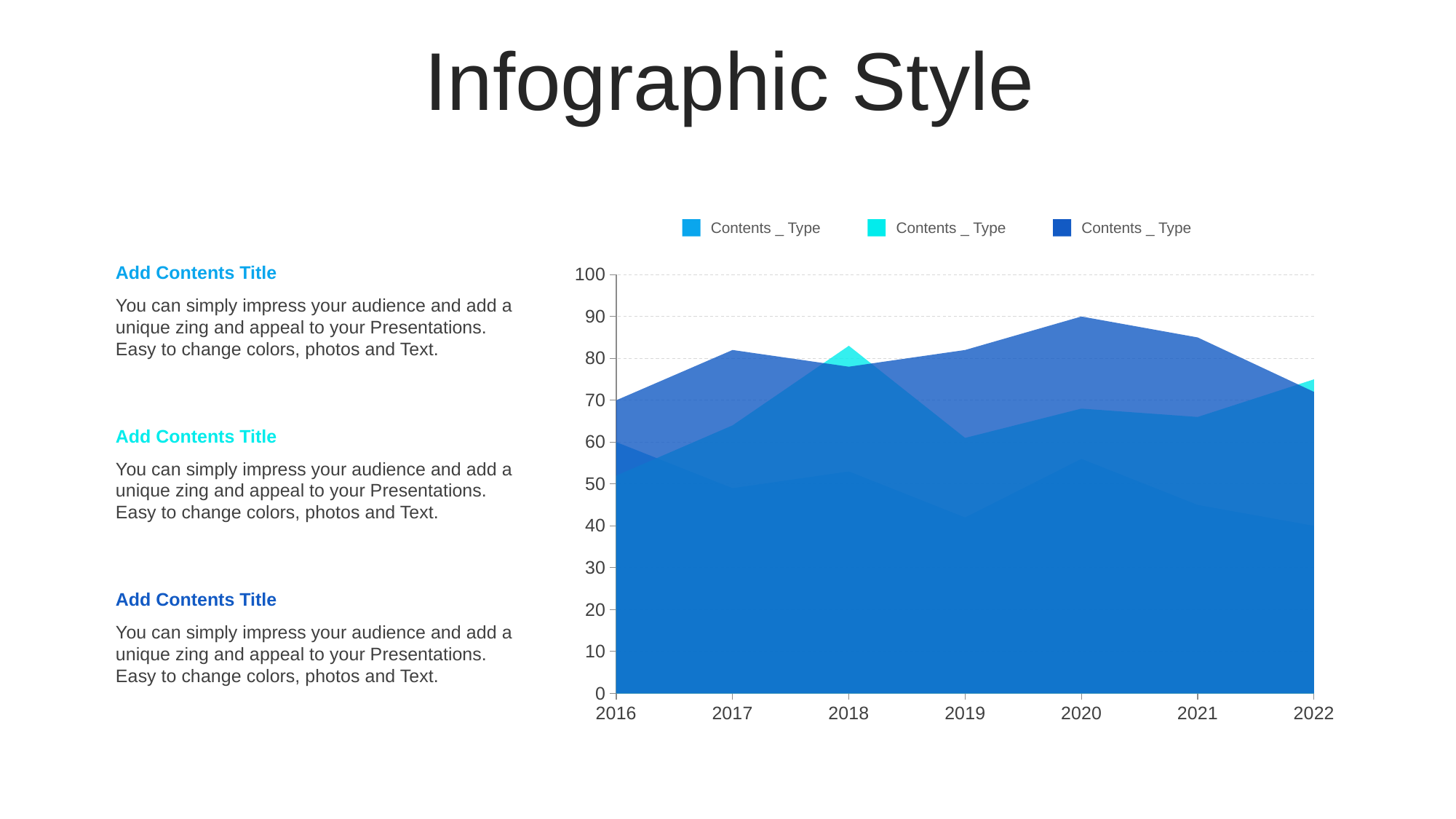
How many years are shown along the x axis of the chart? 7 What is the first year shown on the x axis of the chart? 2016 How many series does the chart legend list? 3 Is the lowest value plotted for 2021 greater or less than 50? less What kind of chart is shown on the slide? area chart Is the highest value plotted for 2020 greater or less than 80? greater Is the highest value plotted for 2016 greater or less than 80? less What is the highest value shown on the chart's y axis? 100